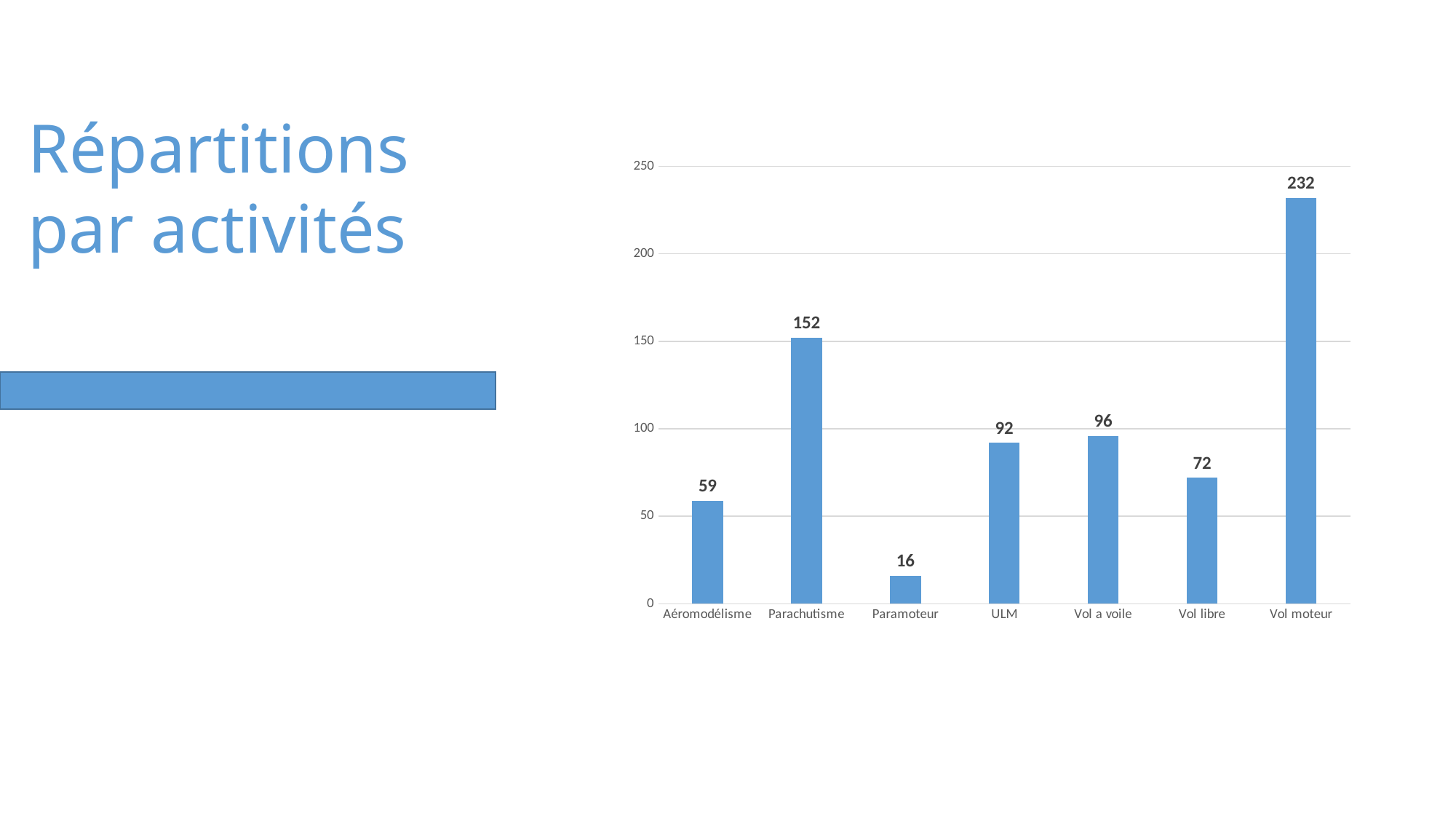
What is the value for Parachutisme? 152 What is the title of the slide containing the chart? Répartitions par activités What is the value for Paramoteur? 16 Is the value for ULM greater or less than 100? less Which is larger, the value for Aéromodélisme or the value for Vol libre? Vol libre What is the value for Vol libre? 72 What is the difference between the values for Vol moteur and Parachutisme? 80 Which activity has the lowest value? Paramoteur Which activity has the highest value? Vol moteur What kind of chart is shown on the slide? bar chart How many activities are shown on the chart? 7 What is the difference between the values for Vol a voile and ULM? 4